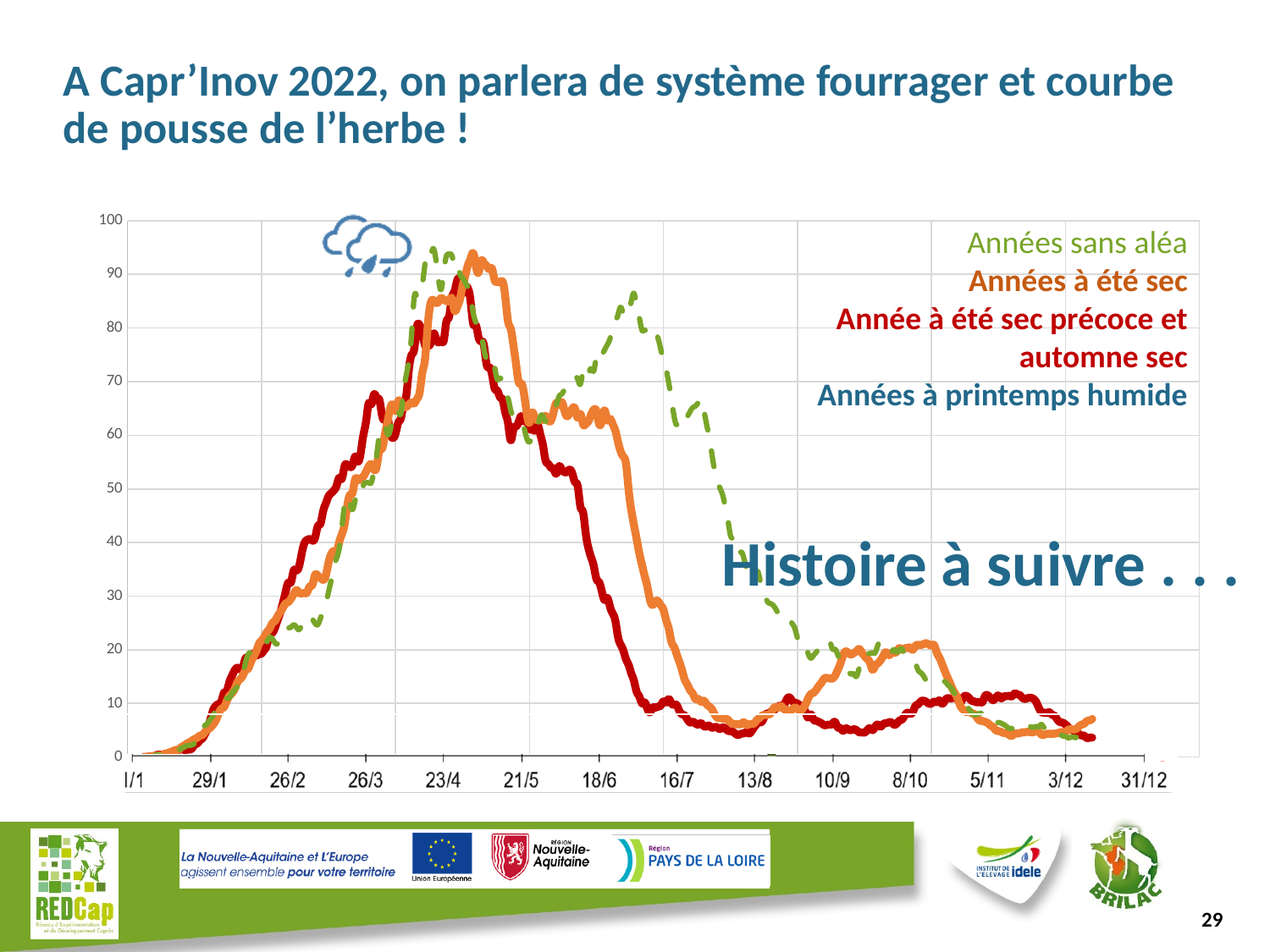
What is the highest value shown on the y axis? 100 How many entries does the legend list? 4 Is the peak value of the 'Années sans aléa' dashed line around 23/4 greater or less than 90? greater Do the values of the lines rise or fall between 1/1 and 23/4? rise How many date labels are shown along the x axis? 14 Does the 'Année à été sec précoce et automne sec' line rise or fall between 18/6 and 16/7? fall Is the value of the 'Années à été sec' line at 8/10 greater or less than 10? greater What kind of chart is shown on the slide? line chart Is the value of the 'Années sans aléa' dashed line at its second peak between 18/6 and 16/7 greater or less than 80? greater What colour is the line for 'Années à été sec'? orange At 16/7, which line is higher: 'Années à été sec' or 'Année à été sec précoce et automne sec'? Années à été sec